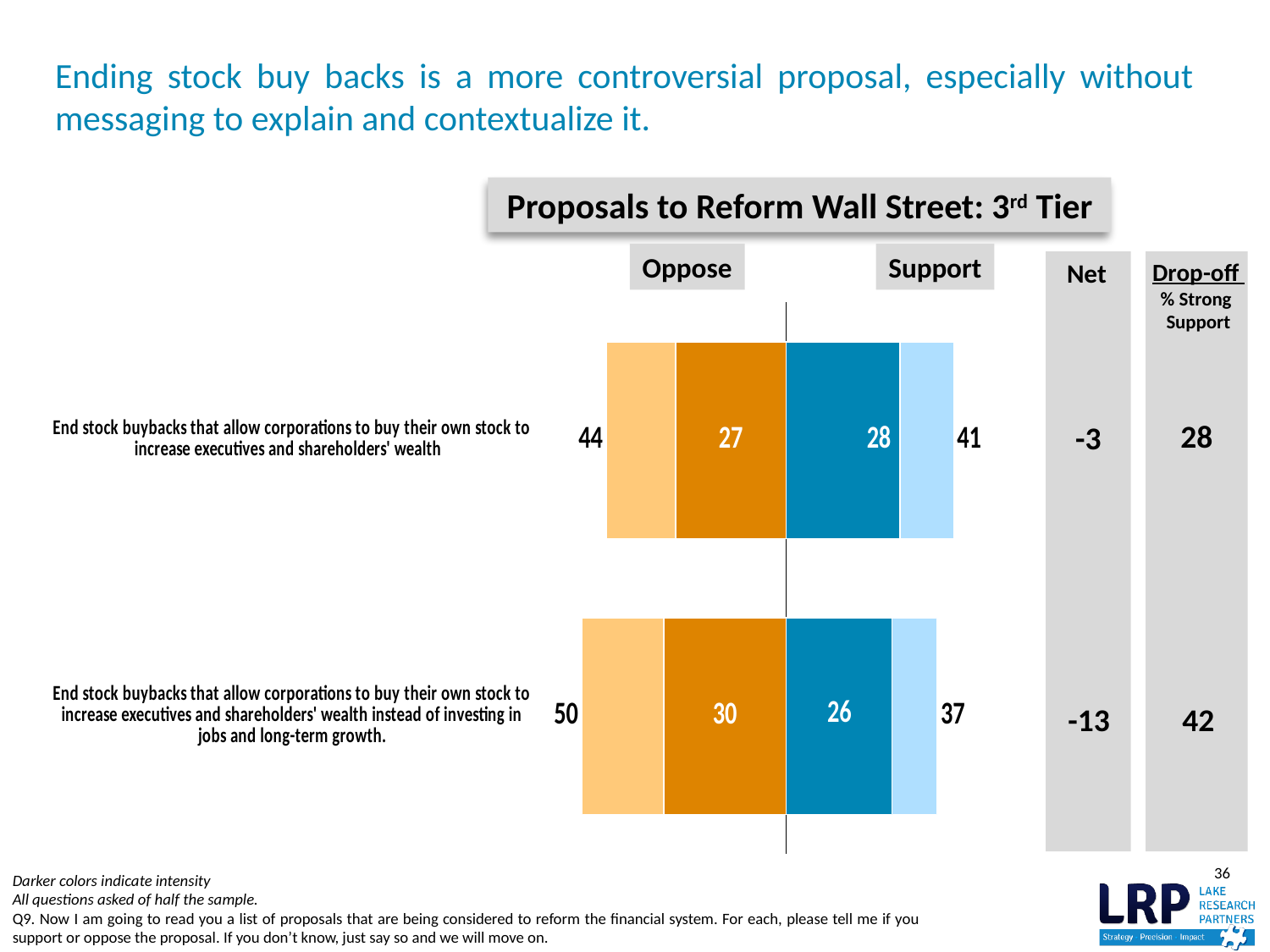
What is the difference between total Support and total Oppose for the top proposal? 3 What is the difference between the total Oppose values of the bottom proposal (50) and the top proposal (44)? 6 What is the Drop-off (% Strong Support) value shown for the top proposal? 28 What is the total Support value for the bottom proposal (the version mentioning 'instead of investing in jobs and long-term growth')? 37 What is the title of the chart? Proposals to Reform Wall Street: 3rd Tier What is the Net value shown for the bottom proposal? -13 What is the total Oppose value for the top proposal (end stock buybacks to increase executives and shareholders' wealth)? 44 Which proposal has the higher total Oppose value, the top one or the bottom one? the bottom one What is the strong support (darker blue) value for the top proposal? 28 What kind of chart is shown on the slide? bar chart How many proposals are plotted on the chart? 2 What is the strong oppose (darker orange) value for the bottom proposal? 30